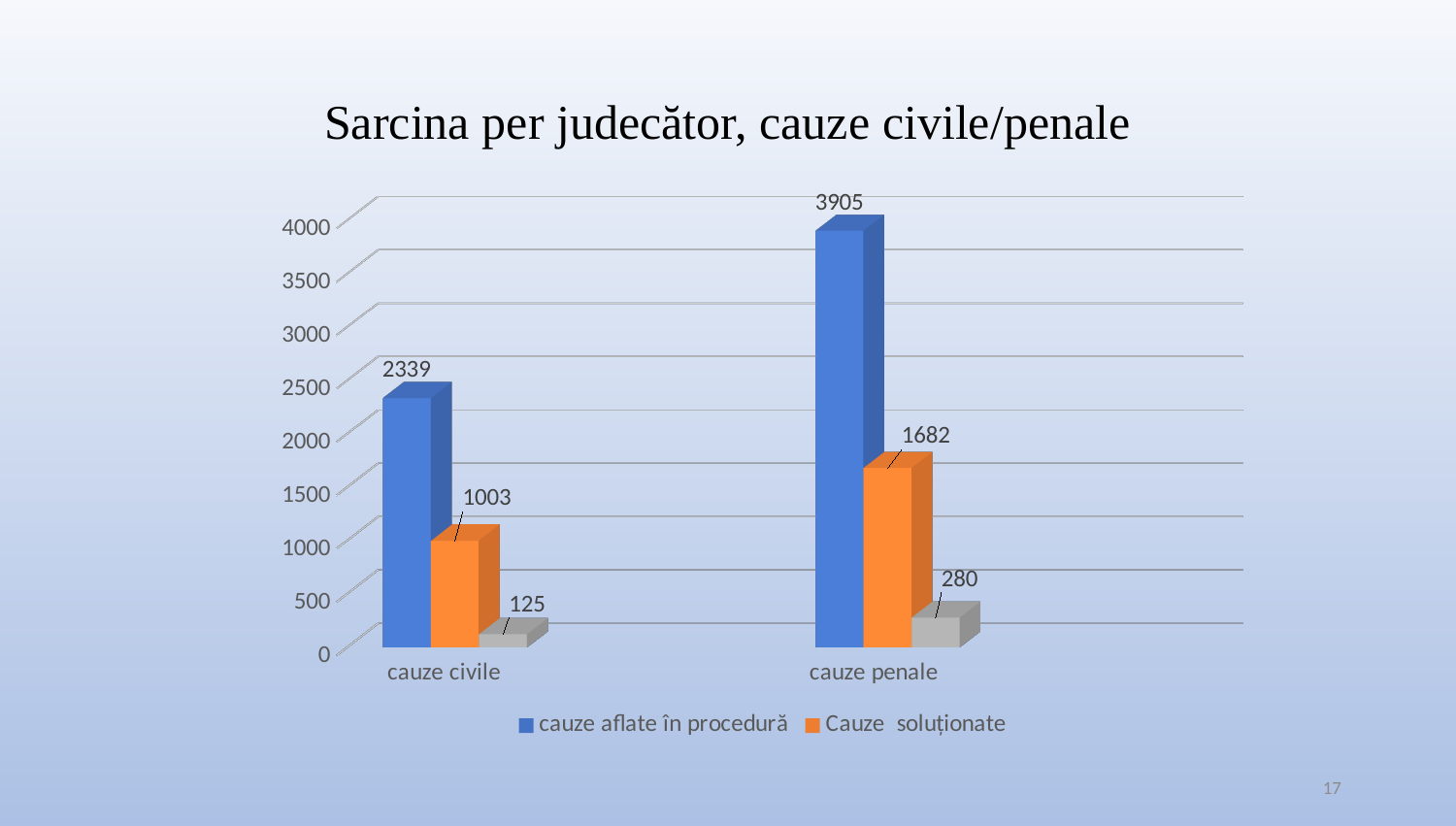
Which category has the higher value for 'cauze aflate în procedură'? cauze penale What is the value of 'cauze aflate în procedură' for 'cauze penale'? 3905 Is 'Cauze soluționate' larger for 'cauze civile' or for 'cauze penale'? cauze penale What is the value of 'Cauze soluționate' for 'cauze civile'? 1003 What is the title of the chart? Sarcina per judecător, cauze civile/penale What is the value of 'cauze aflate în procedură' for 'cauze civile'? 2339 What is the value of 'Cauze soluționate' for 'cauze penale'? 1682 What is the difference between 'cauze aflate în procedură' and 'Cauze soluționate' for 'cauze civile'? 1336 What is the difference between 'cauze aflate în procedură' for 'cauze penale' and for 'cauze civile'? 1566 How many categories are shown on the x axis? 2 How many series does the legend list? 2 What is the value shown on the gray bar for 'cauze penale'? 280